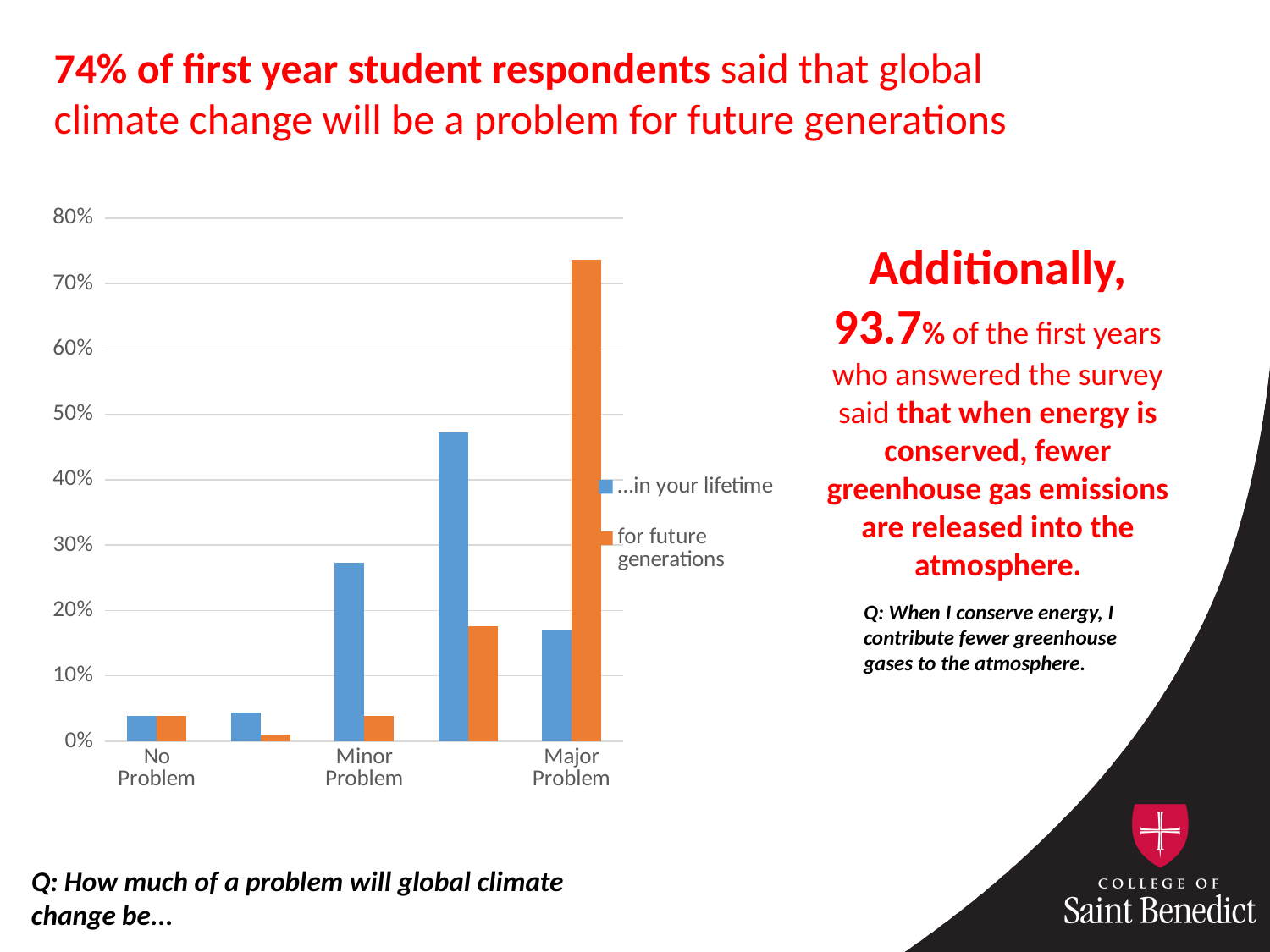
How many groups of bars are plotted along the x axis of the chart? 5 For Minor Problem, which series has the larger value: '...in your lifetime' or 'for future generations'? ...in your lifetime Is the '...in your lifetime' value for Major Problem greater or less than 20%? less How many series does the chart legend list? 2 For Major Problem, which series has the larger value: '...in your lifetime' or 'for future generations'? for future generations What kind of chart is shown on the slide? bar chart What is the highest value shown on the chart's y axis? 80% Is the 'for future generations' value for Minor Problem greater or less than 10%? less Is the '...in your lifetime' value for Minor Problem greater or less than 30%? less Which colour represents the 'for future generations' series in the chart? orange Which category has the highest value for the 'for future generations' series? Major Problem